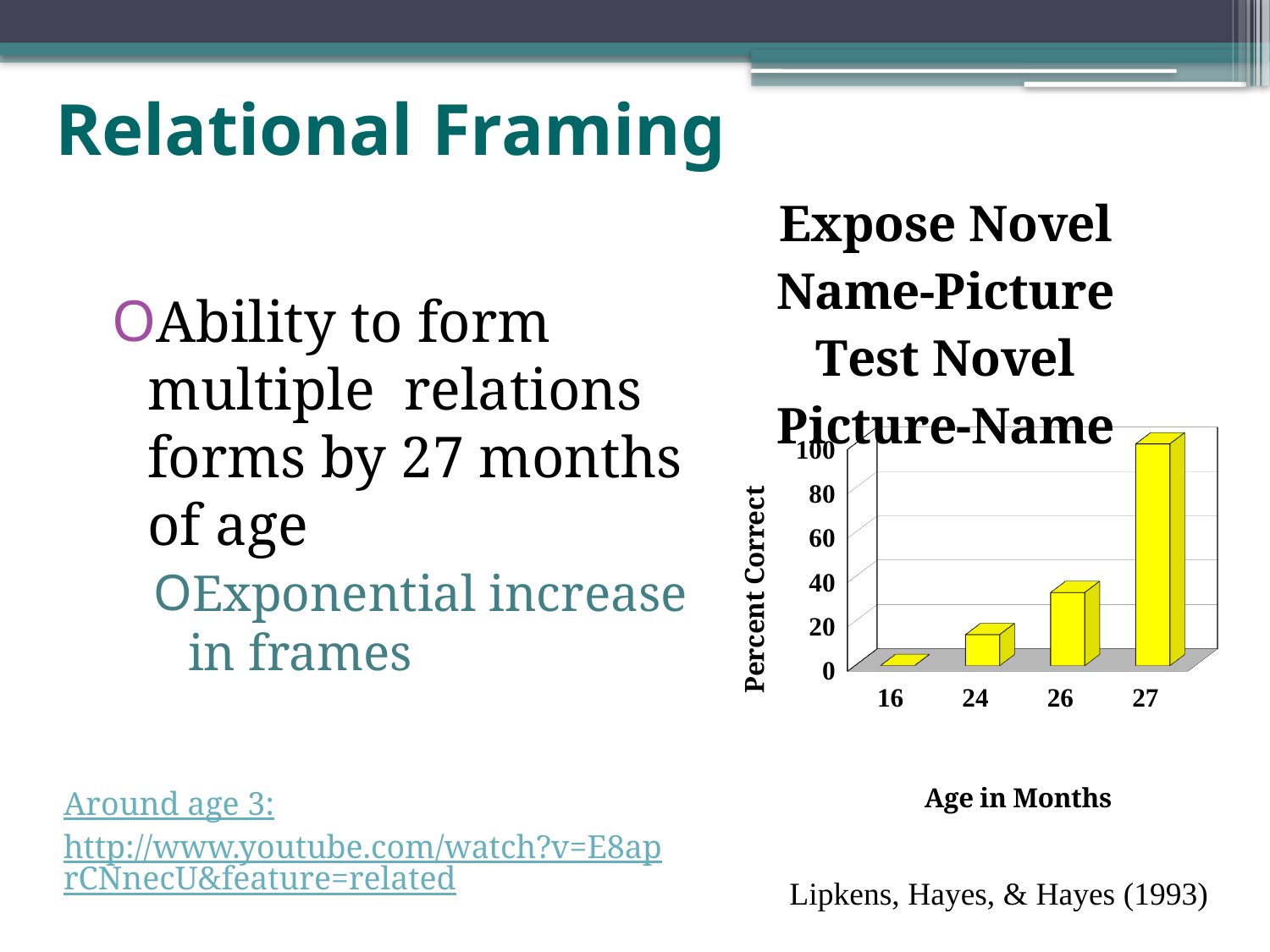
What is the label on the vertical axis of the chart? Percent Correct Is the percent correct at 24 months greater or less than 40? less Which age in months has the lowest percent correct? 16 How many age categories are shown on the x axis of the chart? 4 What kind of chart is shown on the slide? bar chart Is the percent correct at 16 months greater or less than 20? less Is the percent correct at 27 months greater or less than 80? greater What is the label on the horizontal axis of the chart? Age in Months Which has a higher percent correct, 24 months or 26 months? 26 months Which age in months has the highest percent correct? 27 Do the percent correct values rise or fall as age in months increases along the x axis? rise